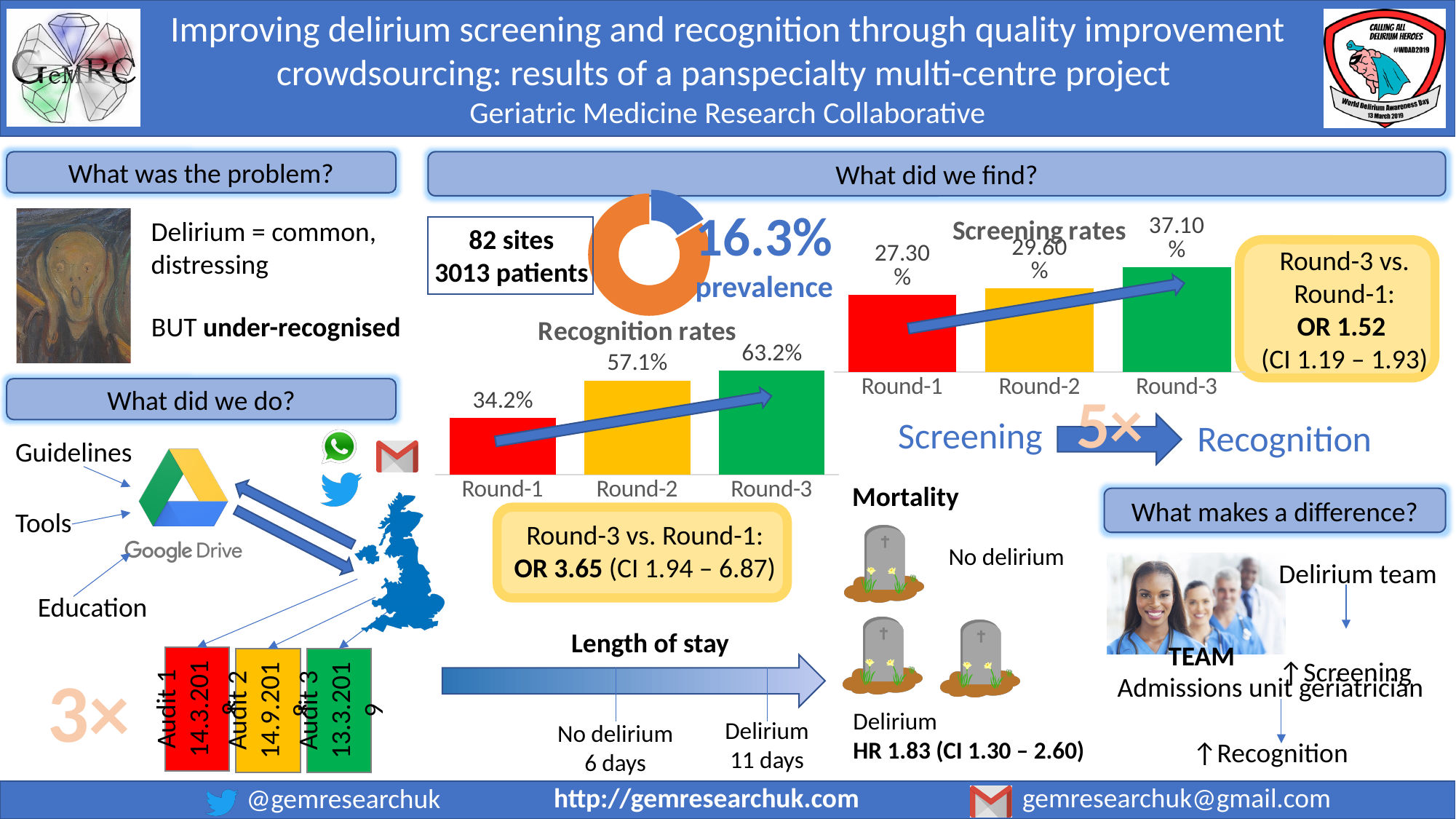
In the Screening rates chart, which round has the lowest value? Round-1 In the Screening rates chart, what is the difference between Round-3 and Round-1? 9.80 percentage points In the Recognition rates chart, which round has the highest value? Round-3 What kind of chart is the Recognition rates chart? Bar chart In the Recognition rates chart, which is larger, Round-2 or Round-1? Round-2 How many rounds are shown in the Screening rates chart? 3 In the Screening rates chart, what is the value for Round-2? 29.60% In the Recognition rates chart, what is the difference between Round-3 and Round-1? 29.0 percentage points In the Screening rates chart, what is the value for Round-3? 37.10% In the Screening rates chart, do the values rise or fall from Round-1 to Round-3? Rise In the Recognition rates chart, what is the value for Round-3? 63.2% In the Recognition rates chart, what is the value for Round-1? 34.2%